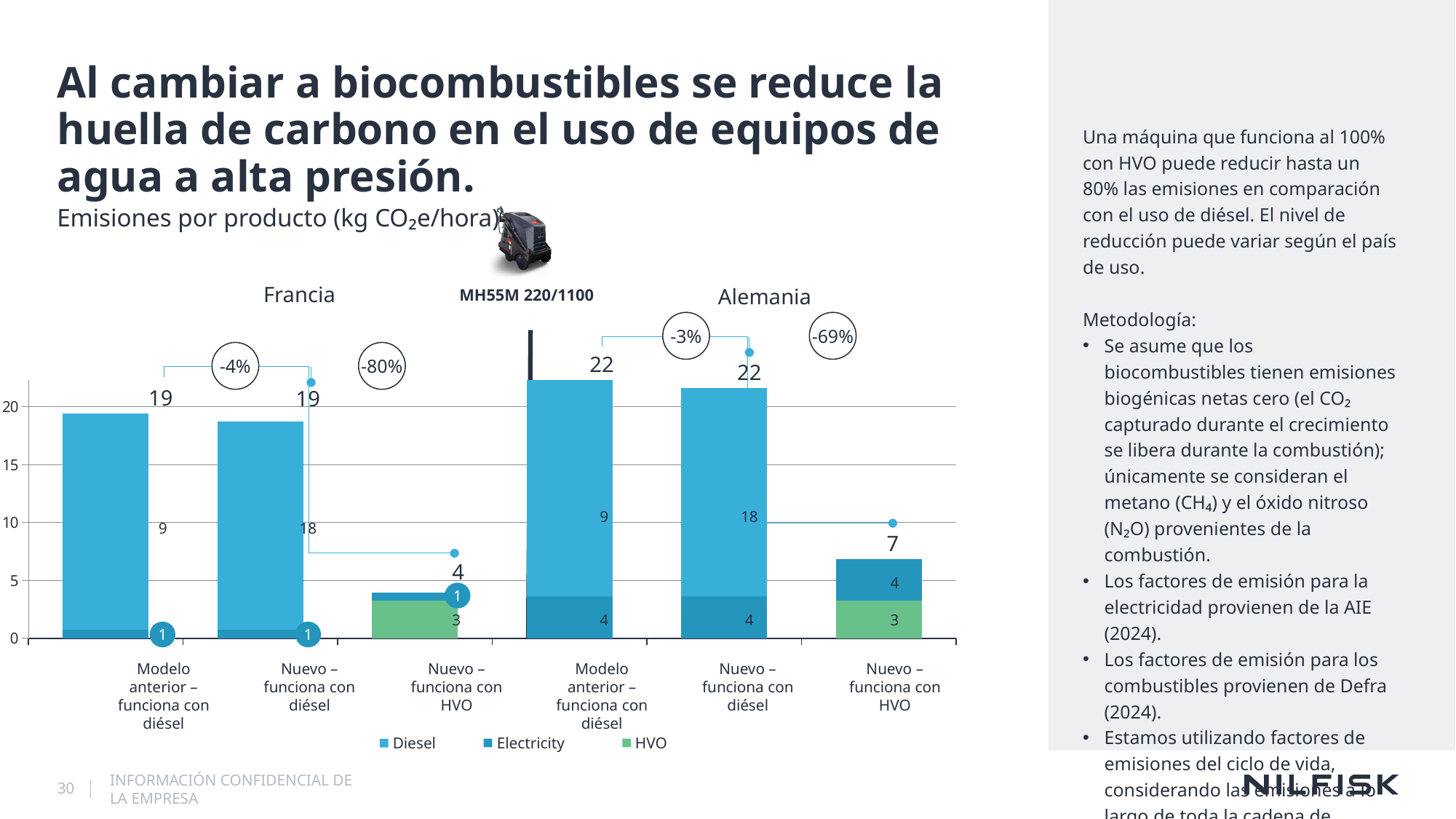
What is the total emissions value for the Francia 'Nuevo – funciona con HVO' bar? 4 How many bars (product scenarios) are plotted in the chart? 6 What kind of chart is shown on the slide? Stacked bar chart What is the total emissions value for the Alemania 'Nuevo – funciona con HVO' bar? 7 What percentage reduction is shown for switching to HVO in Alemania? -69% Which is larger: the total for the Alemania 'Nuevo – funciona con HVO' bar or the Francia 'Nuevo – funciona con HVO' bar? Alemania – Nuevo – funciona con HVO What is the total emissions value for the Alemania 'Modelo anterior – funciona con diésel' bar? 22 How many series does the legend list? 3 What is the HVO segment value in the Alemania 'Nuevo – funciona con HVO' bar? 3 Which series are listed in the legend? Diesel, Electricity, HVO Which bar has the lowest total emissions? Francia – Nuevo – funciona con HVO What is the difference between the total for the Alemania 'Modelo anterior – funciona con diésel' bar and the Francia 'Modelo anterior – funciona con diésel' bar? 3